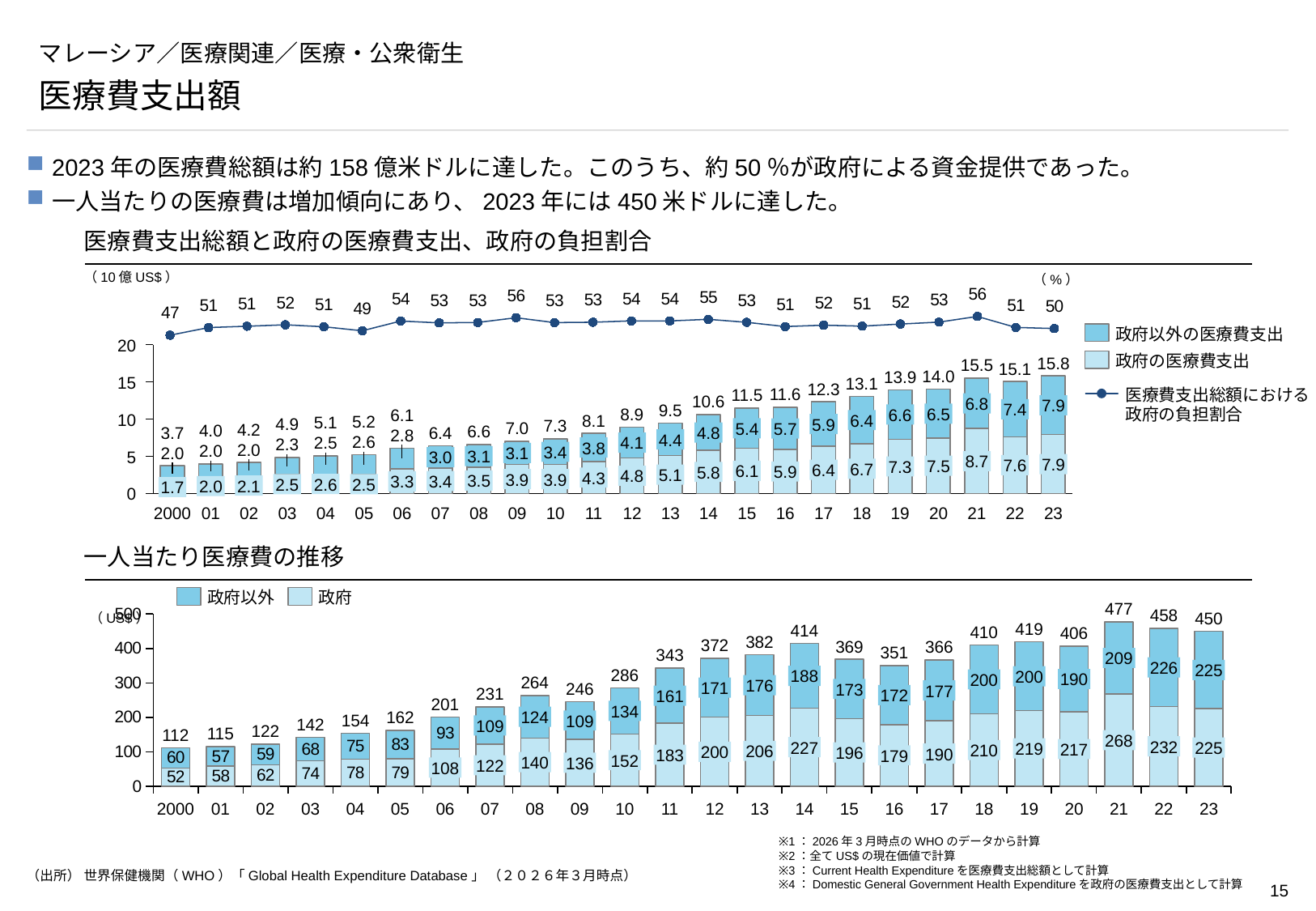
In the top chart, what is the government health expenditure (政府の医療費支出) for 2021? 8.7 In the top chart, which year has the lowest total health expenditure? 2000 In the bottom chart (一人当たり医療費の推移), what is the per-capita health expenditure for 2023 (US$)? 450 In the bottom chart, which year has the highest per-capita health expenditure? 21 In the top chart, what is the government share of total health expenditure (%) for 2000? 47 In the top chart, for 2021, which is larger: government health expenditure or non-government health expenditure? Government health expenditure (政府の医療費支出) How many years are shown on the x axis of the bottom chart? 24 In the bottom chart, what is the difference between the government (政府) and non-government (政府以外) per-capita amounts in 2021? 59 In the top chart (医療費支出総額と政府の医療費支出、政府の負担割合), what is the total health expenditure for 2023 (in 10億US$)? 15.8 In the top chart, what is the difference between the total health expenditure in 2023 and in 2000? 12.1 How many entries does the legend of the top chart list? 3 What kind of chart is the bottom chart (一人当たり医療費の推移)? Stacked bar chart